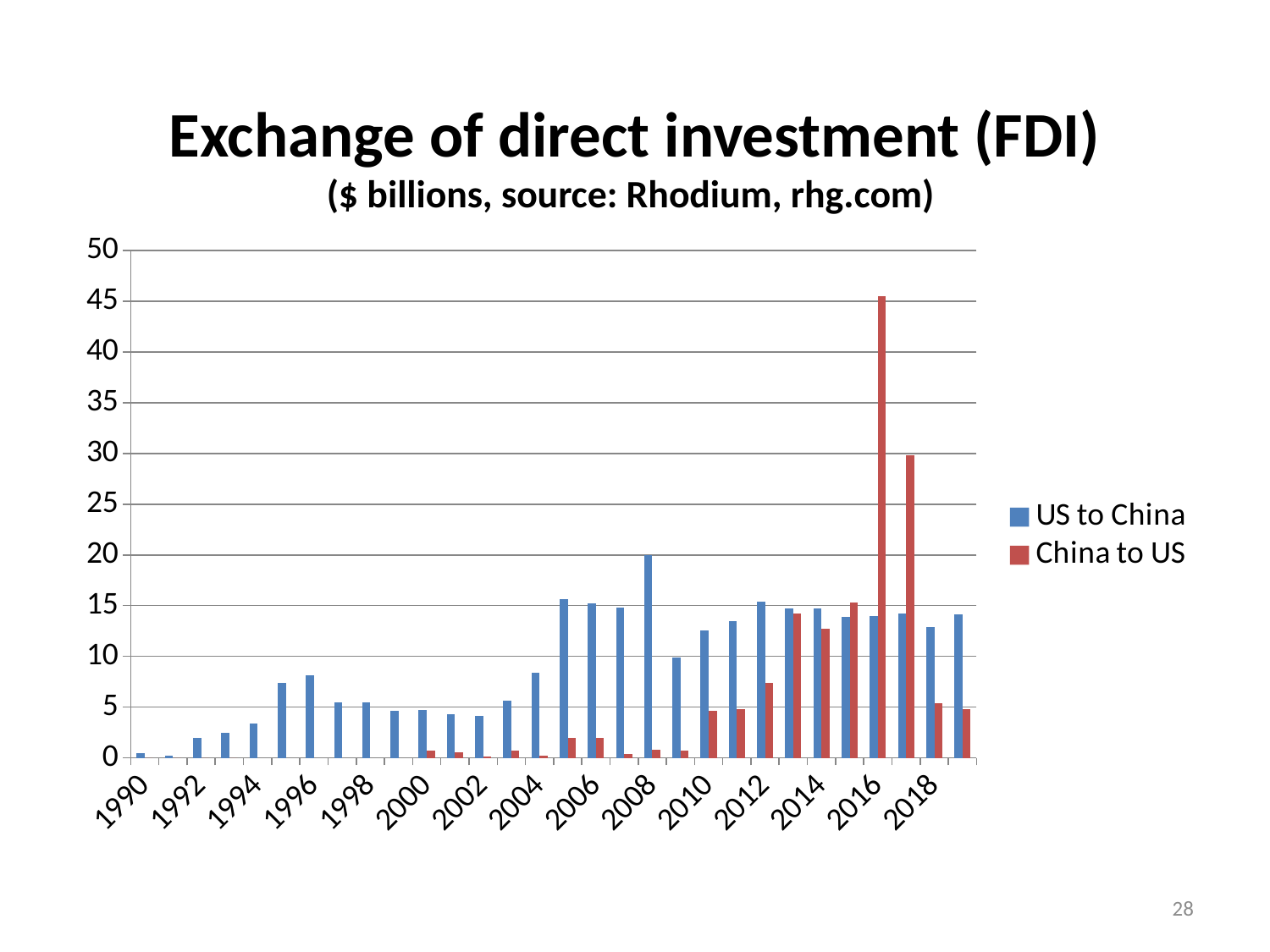
Does the China to US value rise or fall from 2016 to 2019? fall How many years are plotted on the x axis? 30 What kind of chart is shown on the slide? bar chart In 2016, which is larger: US to China or China to US? China to US Is the US to China value for 2008 greater or less than 15? greater In which year is the US to China value highest? 2008 Is the China to US value for 2017 greater or less than 25? greater Is the US to China value for 2004 greater or less than 10? less How many series does the legend list? 2 What are the two series named in the legend? US to China and China to US In which year is the China to US value highest? 2016